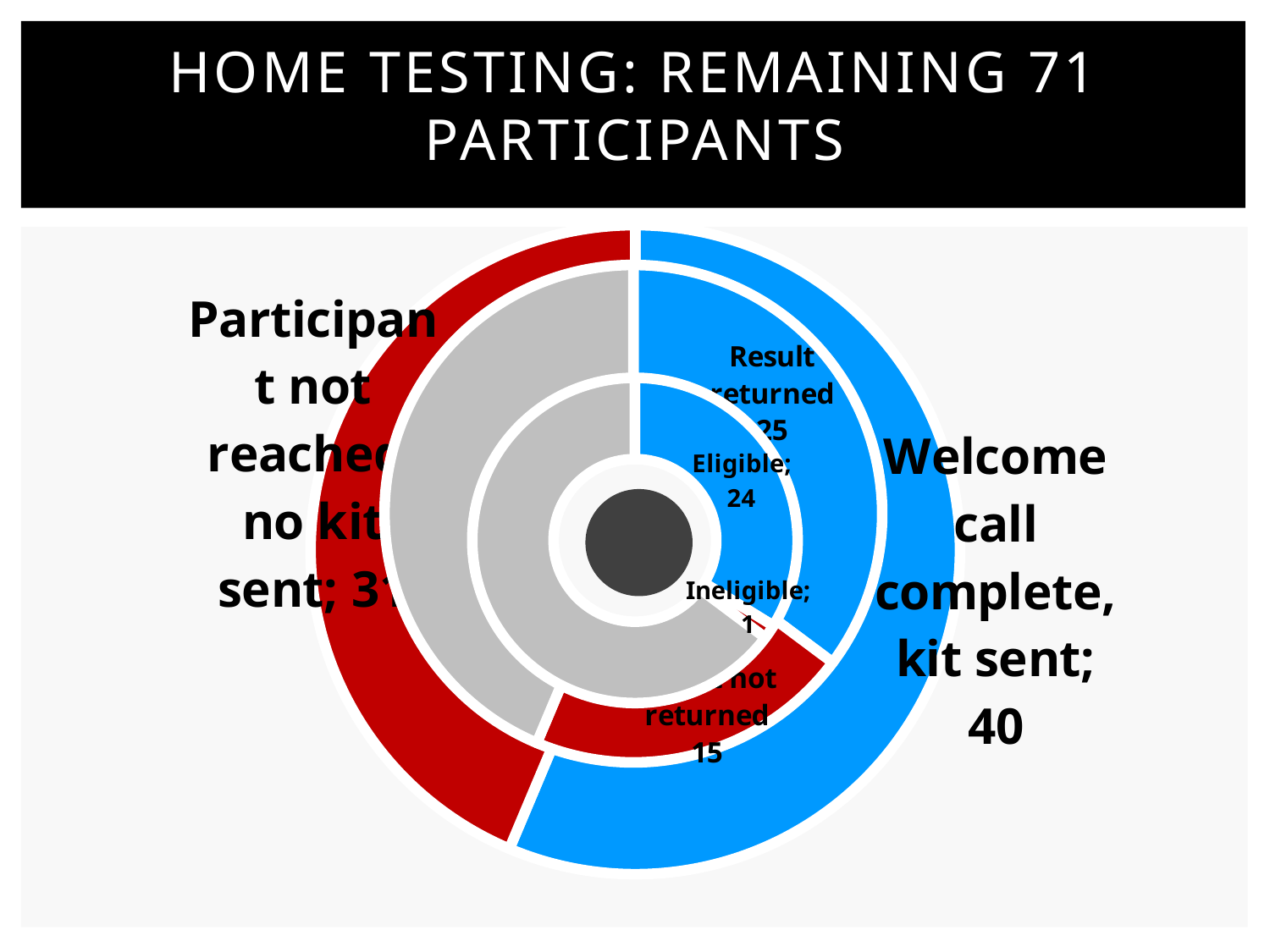
What is the value for 'Result returned' in the middle ring? 25 What kind of chart is shown on the slide? Doughnut chart Which outer-ring segment is larger, 'Welcome call complete, kit sent' or 'Participant not reached, no kit sent'? Welcome call complete, kit sent What colour is the 'Welcome call complete, kit sent' segment? Blue Which is larger, 'Eligible' or 'Ineligible'? Eligible What is the value for 'Ineligible' in the inner ring? 1 How many segments does the outer ring of the chart have? 2 What is the value for 'Welcome call complete, kit sent' in the outer ring? 40 What is the value for 'Eligible' in the inner ring? 24